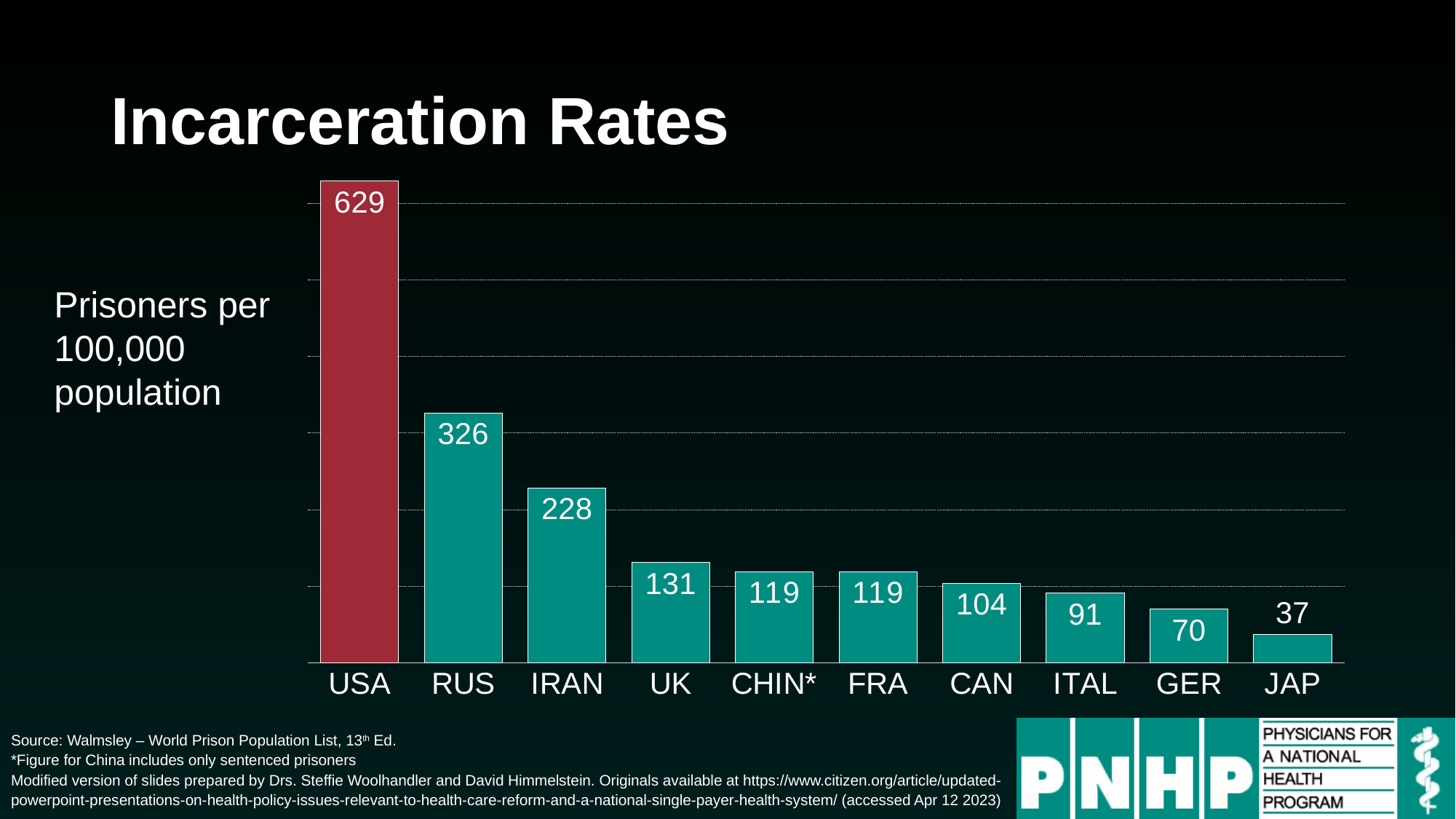
What is the difference between the values for IRAN and UK? 97 Which country has the lowest incarceration rate? JAP How many countries are shown on the chart? 10 What is the value shown for RUS? 326 Do the values rise or fall moving from left to right along the x axis? Fall What is the title of the chart? Incarceration Rates What is the incarceration rate for the USA? 629 What is the difference between the values for USA and RUS? 303 Which country has the highest incarceration rate? USA What is the value shown for CAN? 104 Which has a larger value, ITAL or GER? ITAL What kind of chart is shown on the slide? Bar chart